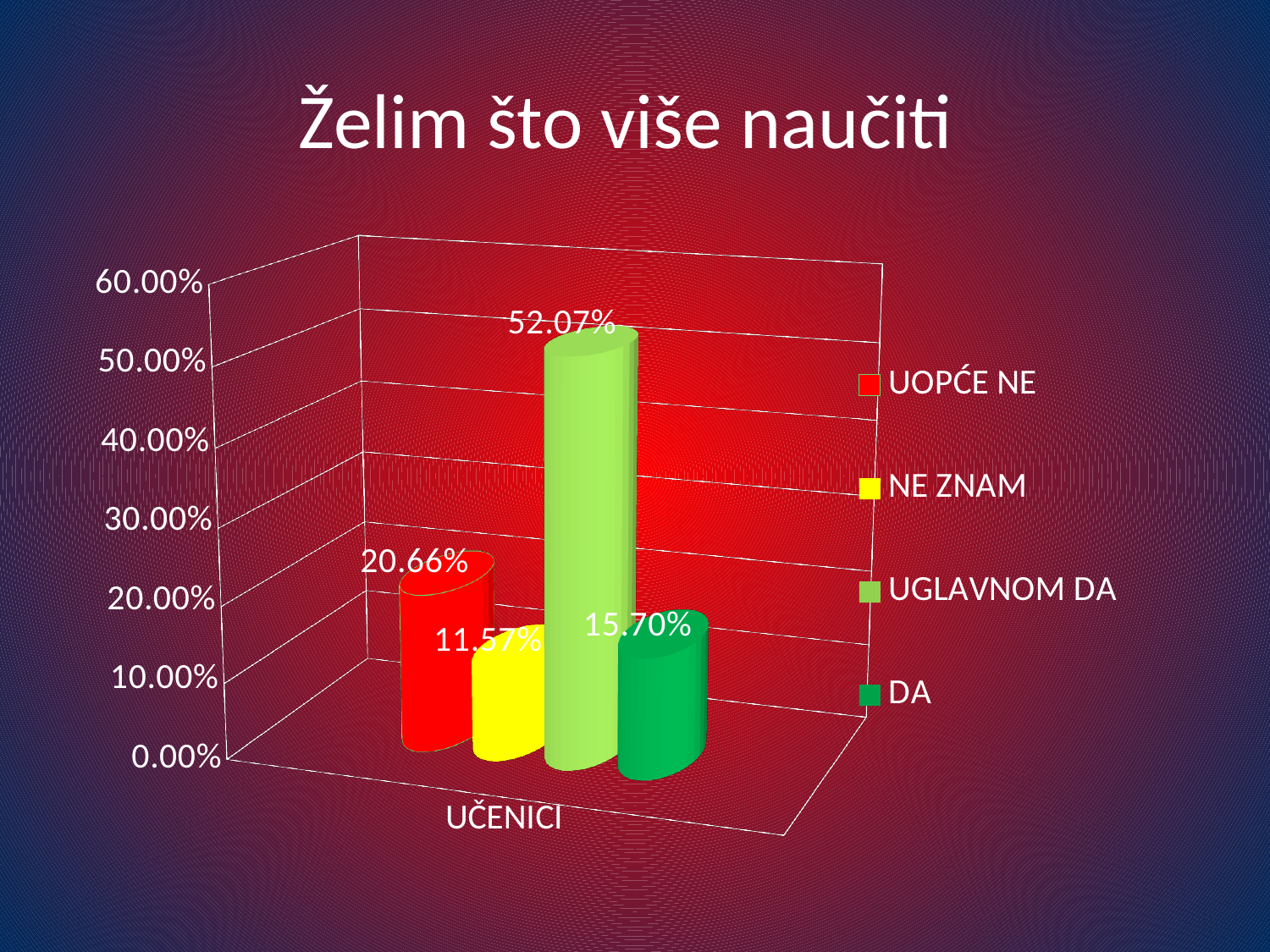
What is the title of the chart? Želim što više naučiti What is the value for UOPĆE NE? 20.66% Is the value for UOPĆE NE greater or less than 30.00%? less What is the value for NE ZNAM? 11.57% Which series has the lowest value? NE ZNAM What kind of chart is shown on the slide? bar chart How many series does the legend list? 4 Which is larger, the value for DA or the value for NE ZNAM? DA Which series has the highest value? UGLAVNOM DA What is the value for DA? 15.70% What is the value for UGLAVNOM DA? 52.07% What is the difference between the values for UGLAVNOM DA and UOPĆE NE? 31.41%